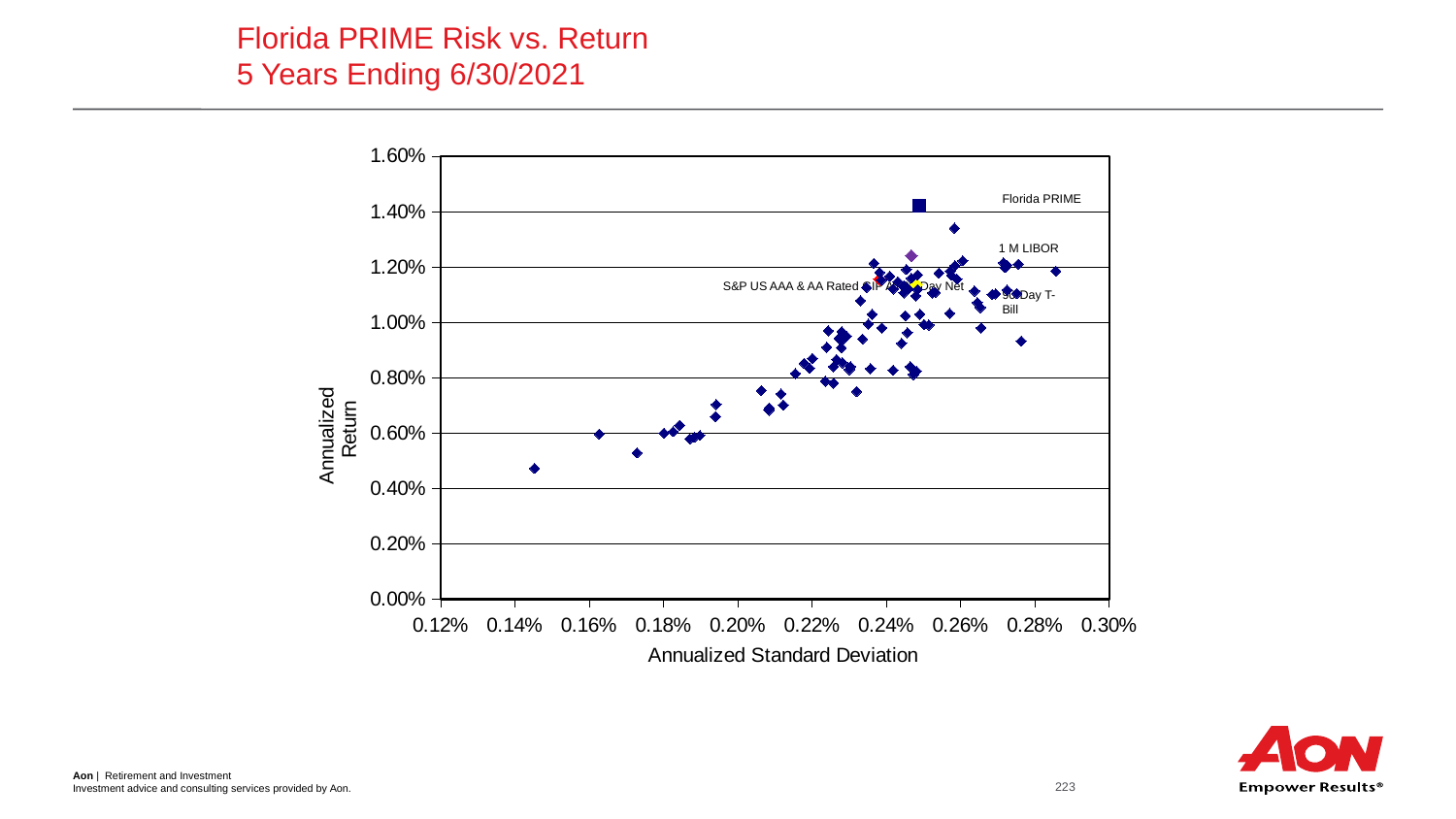
Which has the higher annualized return, Florida PRIME or 90 Day T-Bill? Florida PRIME What is the label of the horizontal axis? Annualized Standard Deviation What is the title of the chart? Florida PRIME Risk vs. Return 5 Years Ending 6/30/2021 Is the annualized standard deviation for Florida PRIME greater or less than 0.26%? less Is the annualized return for 1 M LIBOR greater or less than 1.40%? less Is the annualized standard deviation for Florida PRIME greater or less than 0.24%? greater Do annualized returns generally rise or fall as annualized standard deviation increases? rise Which labeled point has the highest annualized return? Florida PRIME What kind of chart is shown on the slide? Scatter chart Which has the higher annualized return, Florida PRIME or 1 M LIBOR? Florida PRIME